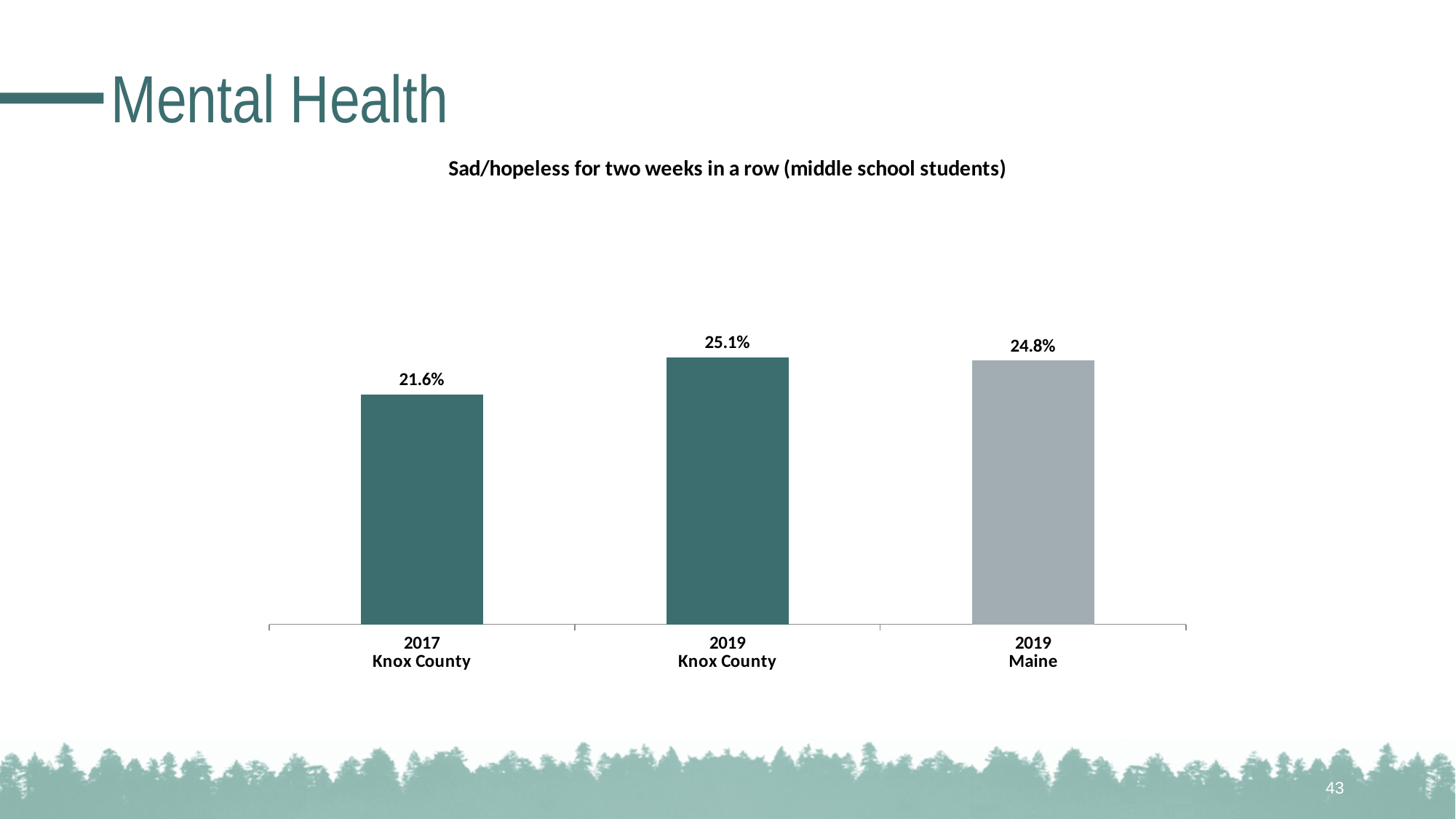
What is the value for 2019 Maine? 24.8% Which is larger, the value for 2017 Knox County or the value for 2019 Maine? 2019 Maine What is the title of the chart? Sad/hopeless for two weeks in a row (middle school students) How many bars are shown in the chart? 3 What is the value for 2017 Knox County? 21.6% Which category has the highest value? 2019 Knox County What kind of chart is shown on the slide? Bar chart What is the value for 2019 Knox County? 25.1% Which category has the lowest value? 2017 Knox County What is the difference between the 2019 Knox County value and the 2019 Maine value? 0.3% What is the difference between the 2019 Knox County value and the 2017 Knox County value? 3.5% Did the Knox County value rise or fall from 2017 to 2019? Rise